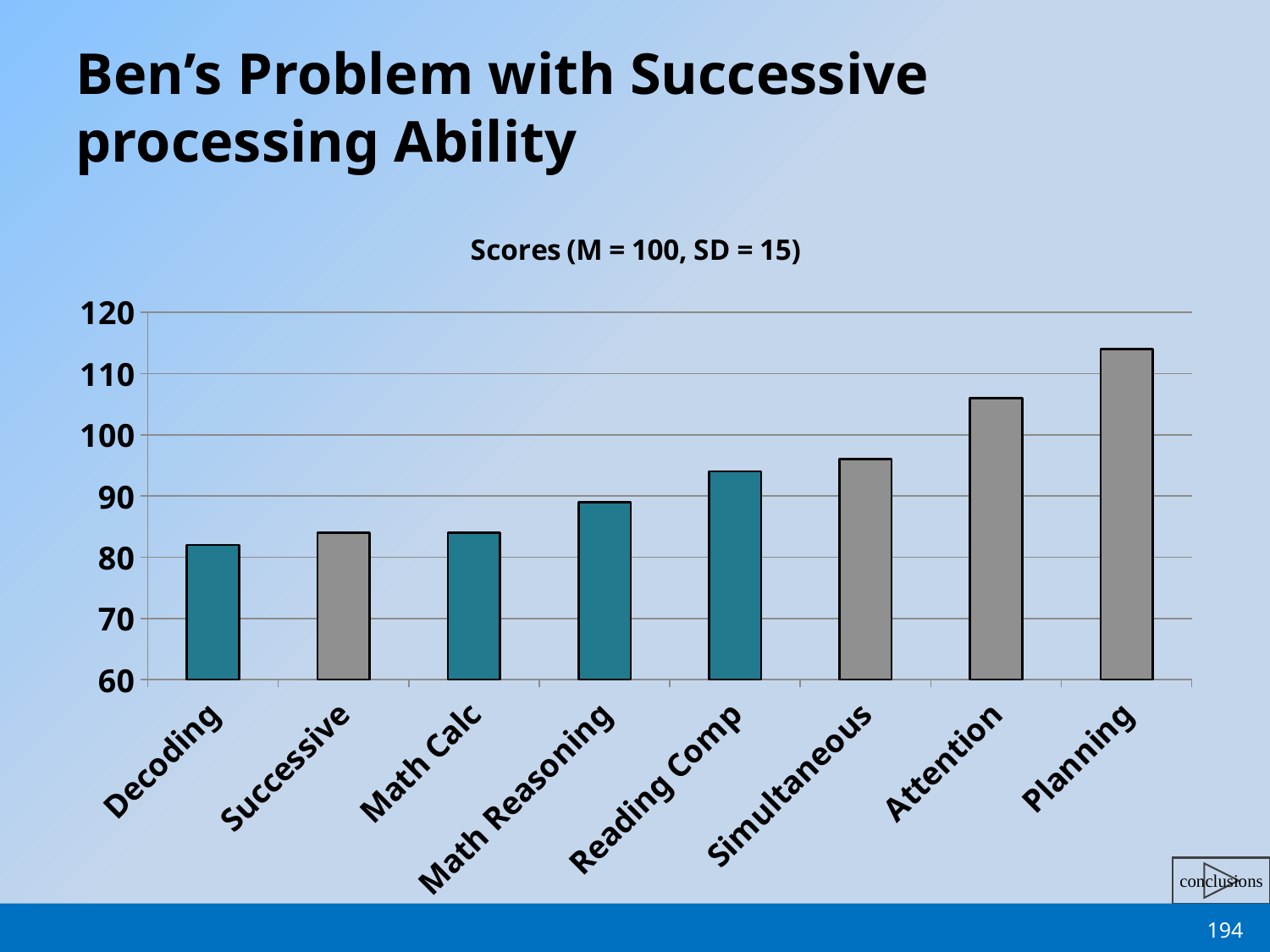
What is the title of the chart? Scores (M = 100, SD = 15) How many categories are plotted on the x axis of the chart? 8 What kind of chart is shown on the slide? bar chart Which is larger, the value for Reading Comp or the value for Math Reasoning? Reading Comp Is the value for Math Reasoning greater or less than 80? greater Is the value for Attention greater or less than 100? greater Which is larger, the value for Attention or the value for Planning? Planning Do the values rise or fall moving from left to right along the x axis? rise Is the value for Simultaneous greater or less than 100? less Which category has the highest score in the chart? Planning